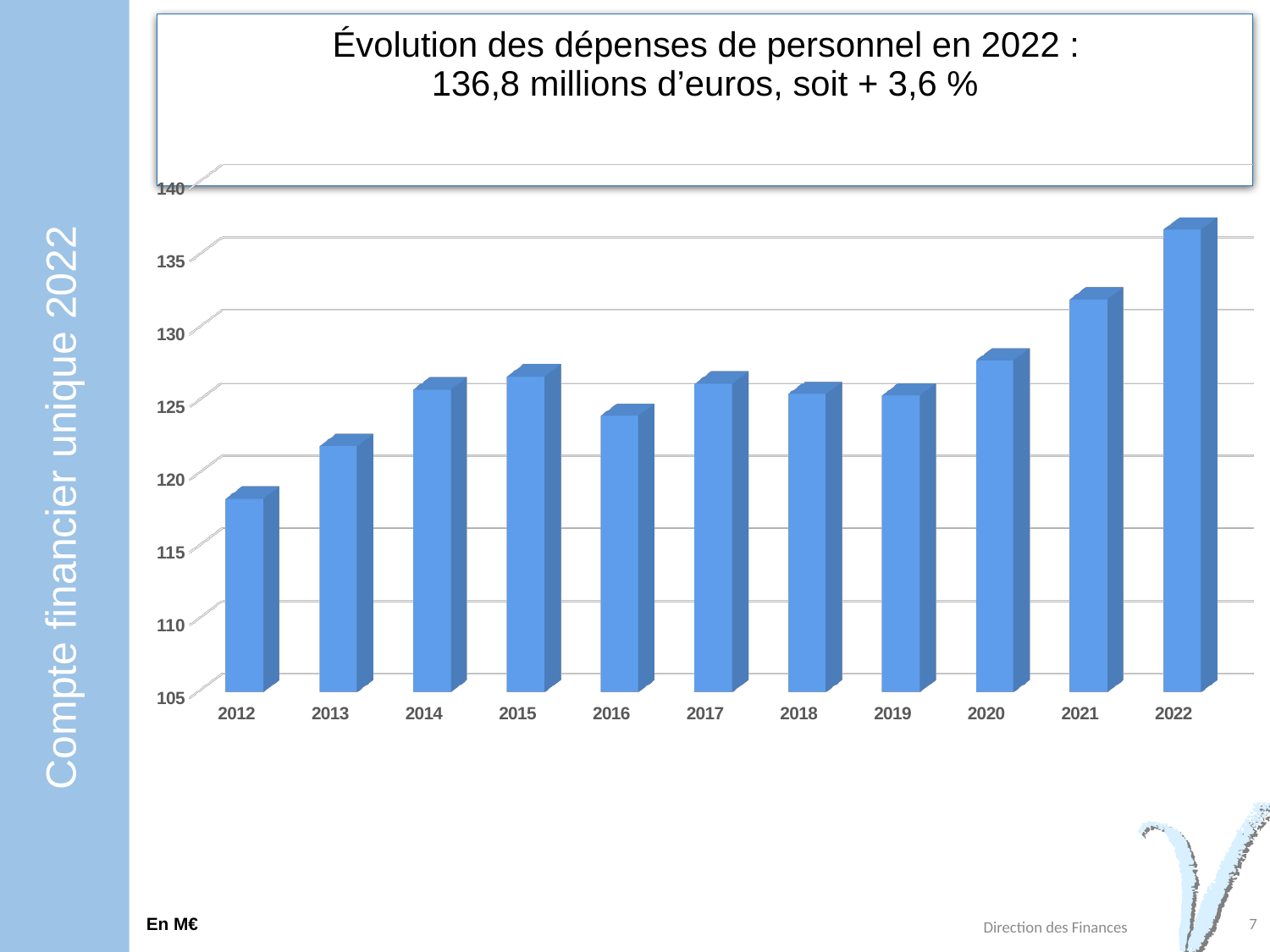
Do the values generally rise or fall from 2012 to 2022? rise Which year has the highest personnel expenditure in the chart? 2022 Is the value for 2020 greater or less than 125? greater Which year has the lowest personnel expenditure in the chart? 2012 In what unit are the chart values expressed, according to the note at the bottom left? En M€ According to the slide, what were the personnel expenses in 2022? 136,8 millions d'euros How many years are shown on the x axis of the chart? 11 Is the value for 2012 greater or less than 120? less Is the value for 2016 greater or less than 125? less What kind of chart is shown on the slide? bar chart Which is larger, the value for 2021 or the value for 2016? 2021